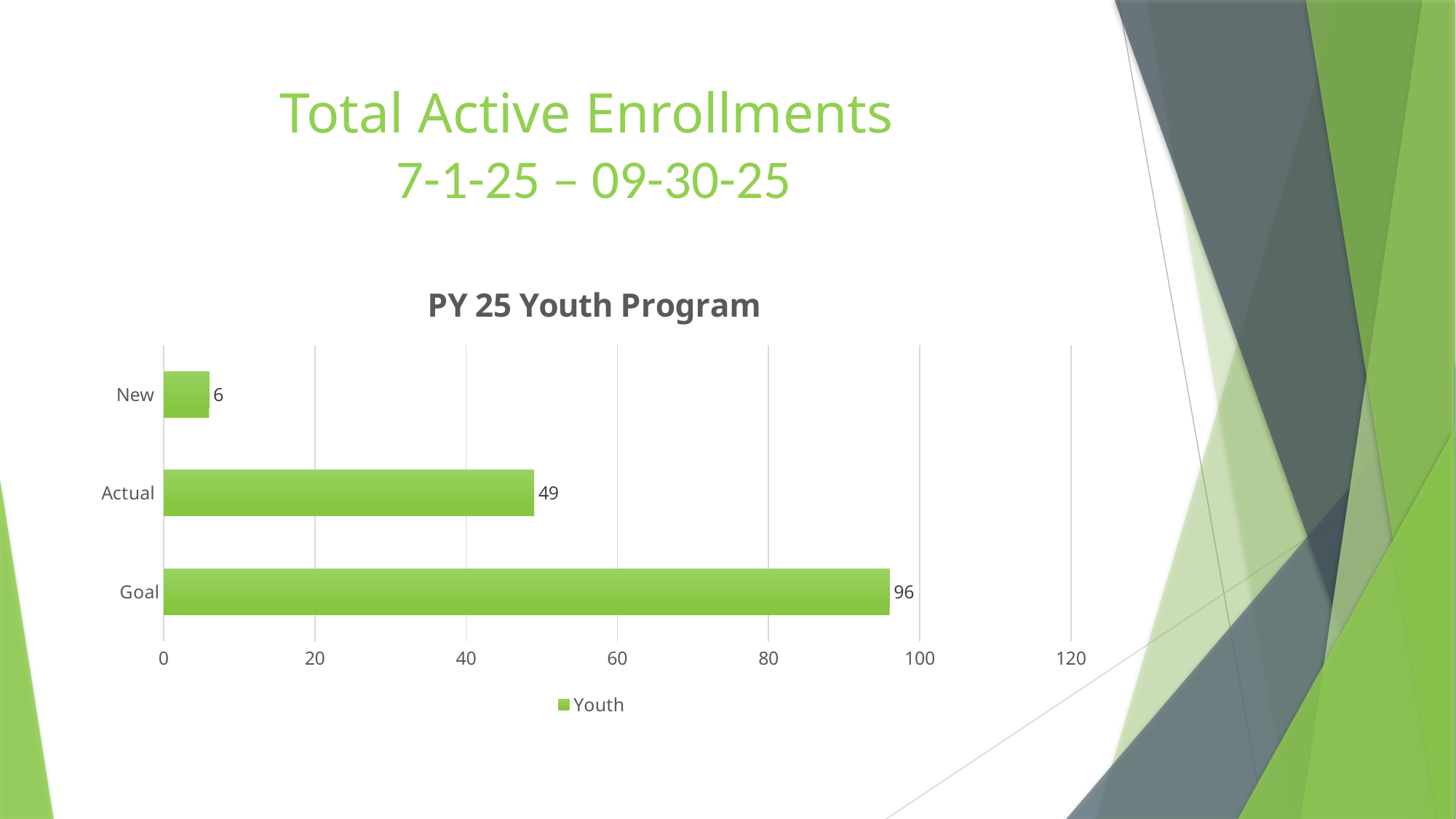
What is the value for New? 6 Which category has the lowest value? New Is the value for Goal greater or less than 100? less What is the value for Goal? 96 Which category has the highest value? Goal What is the value for Actual? 49 What is the title of the chart? PY 25 Youth Program How many categories are shown in the chart? 3 What is the difference between the Goal and Actual values? 47 Which is larger, the value for Actual or the value for New? Actual What kind of chart is shown on the slide? bar chart What is the difference between the Actual and New values? 43